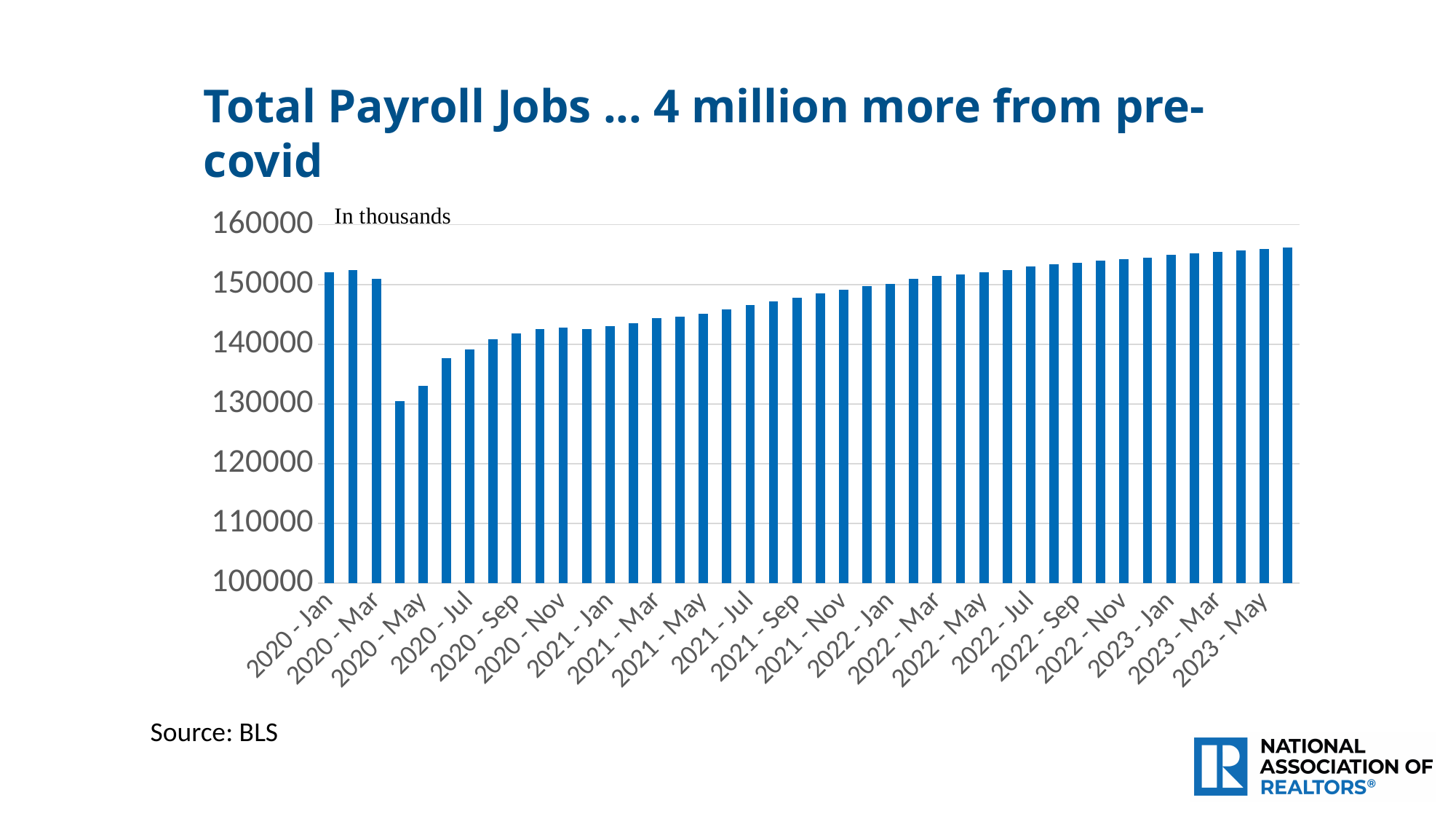
Is the value for 2020 - May greater or less than 130000? greater Is the value for 2020 - Jul greater or less than 140000? less In what units are the values on the chart expressed, according to the note above the axis? In thousands Is the value for 2020 - Jan greater or less than 150000? greater What kind of chart is shown on the slide? bar chart Do the values generally rise or fall from 2020 - May to 2023 - May? rise What is the title of the chart? Total Payroll Jobs … 4 million more from pre-covid Which is larger, the value for 2020 - Jan or the value for 2020 - Sep? 2020 - Jan Which is lower, the value for 2020 - May or the value for 2020 - Jul? 2020 - May